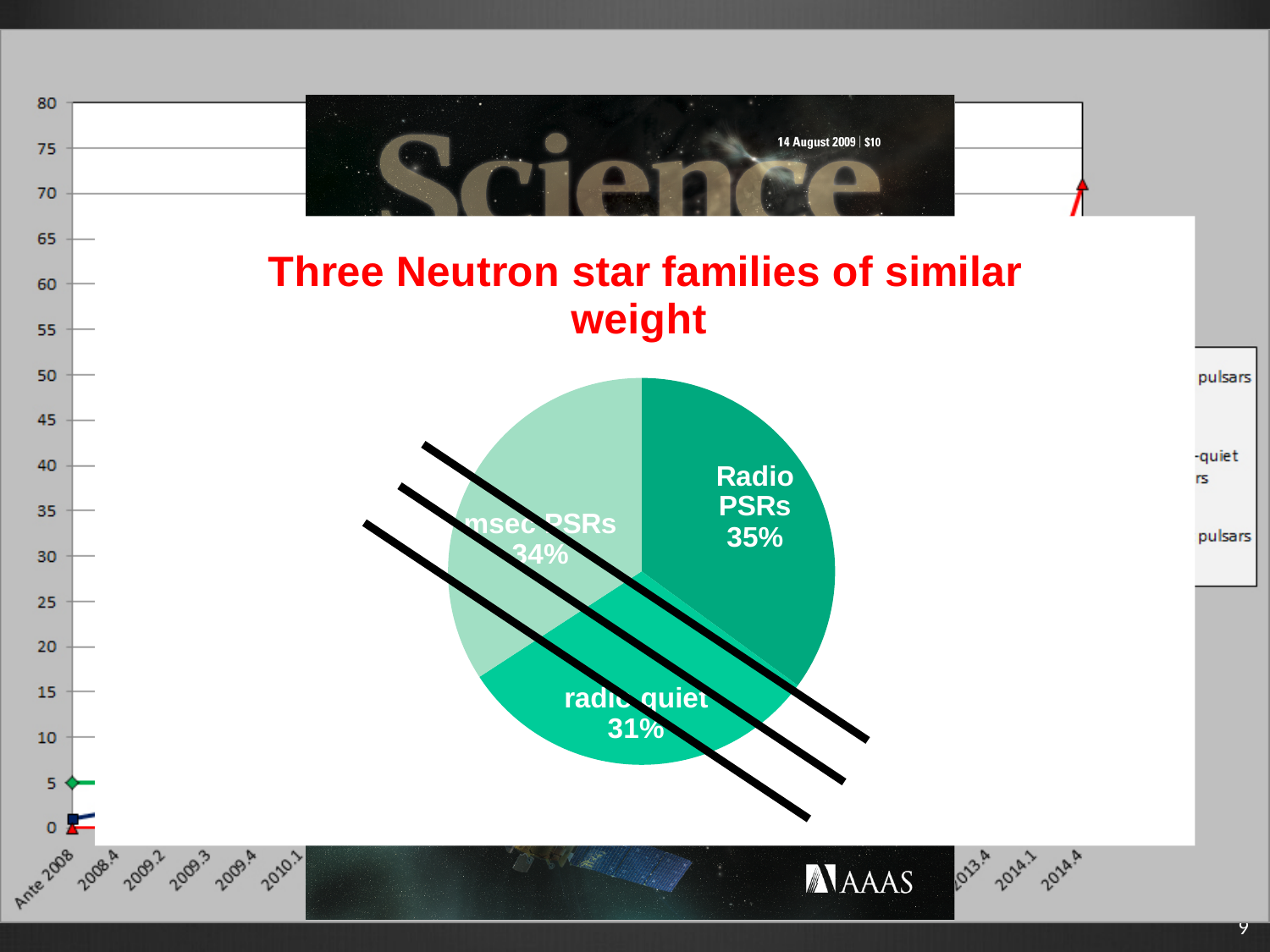
In the pie chart, what is the difference in percentage points between Radio PSRs and msec PSRs? 1 In the pie chart, what share is labelled for radio quiet? 31% What kind of chart is shown in the centre of the slide? pie chart How many slices does the pie chart have? 3 Which slice of the pie chart is the smallest? radio quiet In the pie chart, what share is labelled for Radio PSRs? 35% In the pie chart, which is larger: the Radio PSRs share or the radio quiet share? Radio PSRs Which slice of the pie chart is the largest? Radio PSRs In the pie chart, what is the difference in percentage points between Radio PSRs and radio quiet? 4 In the pie chart, is the share for radio quiet greater or less than 50%? less In the pie chart, what share is labelled for msec PSRs? 34% What is the title shown above the pie chart? Three Neutron star families of similar weight